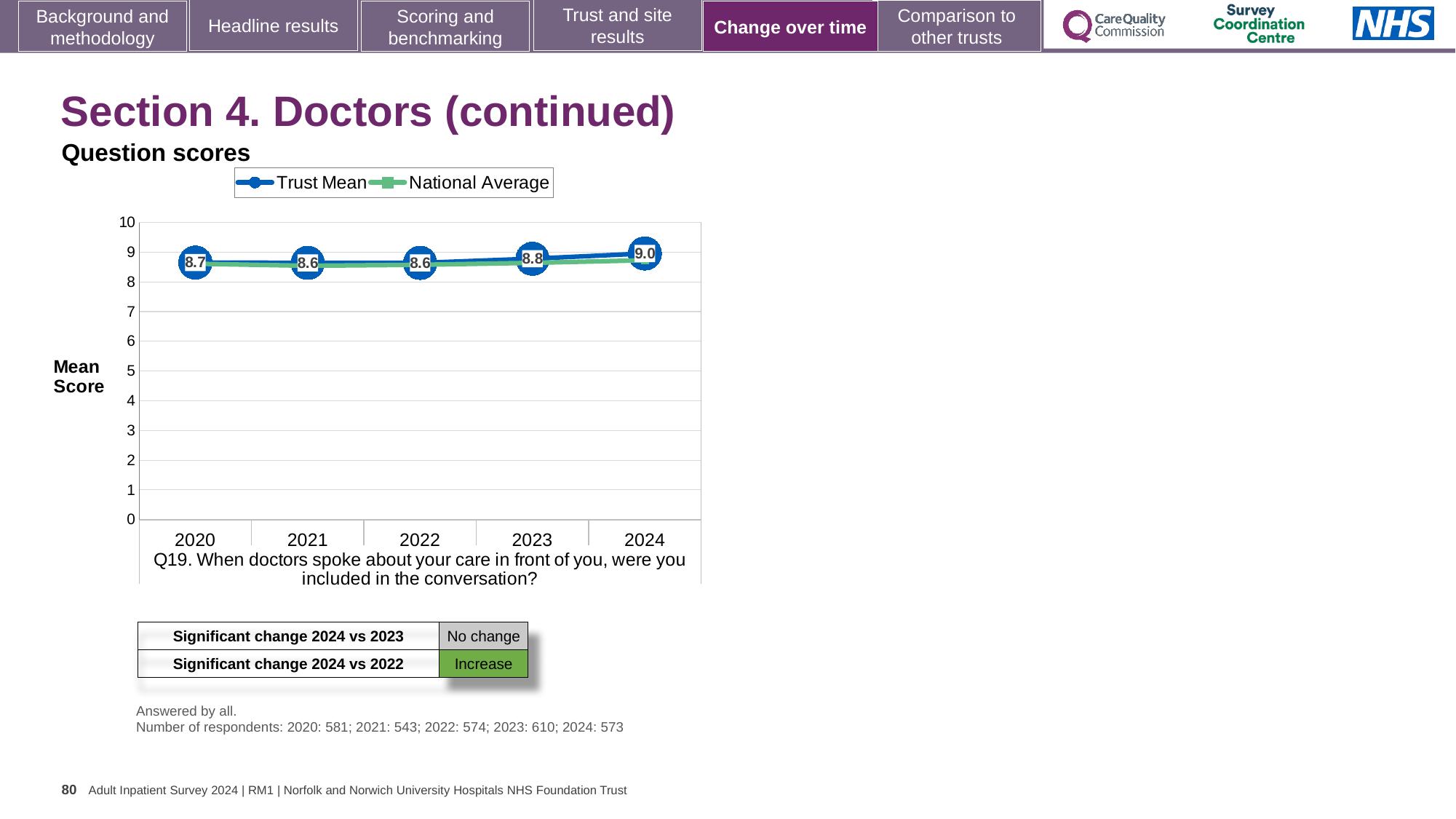
In which year is the Trust Mean score highest? 2024 What is the Trust Mean score for 2023? 8.8 How many series does the legend list? 2 How many years are plotted on the x axis? 5 What is the label of the y axis? Mean Score Does the Trust Mean score rise or fall between 2022 and 2024? rise Which year has the larger Trust Mean score, 2023 or 2024? 2024 What is the difference between the Trust Mean scores for 2024 and 2020? 0.3 Is the National Average value for 2024 greater or less than 8? greater What kind of chart is shown? line chart What is the Trust Mean score for 2024? 9.0 What is the Trust Mean score for 2020? 8.7